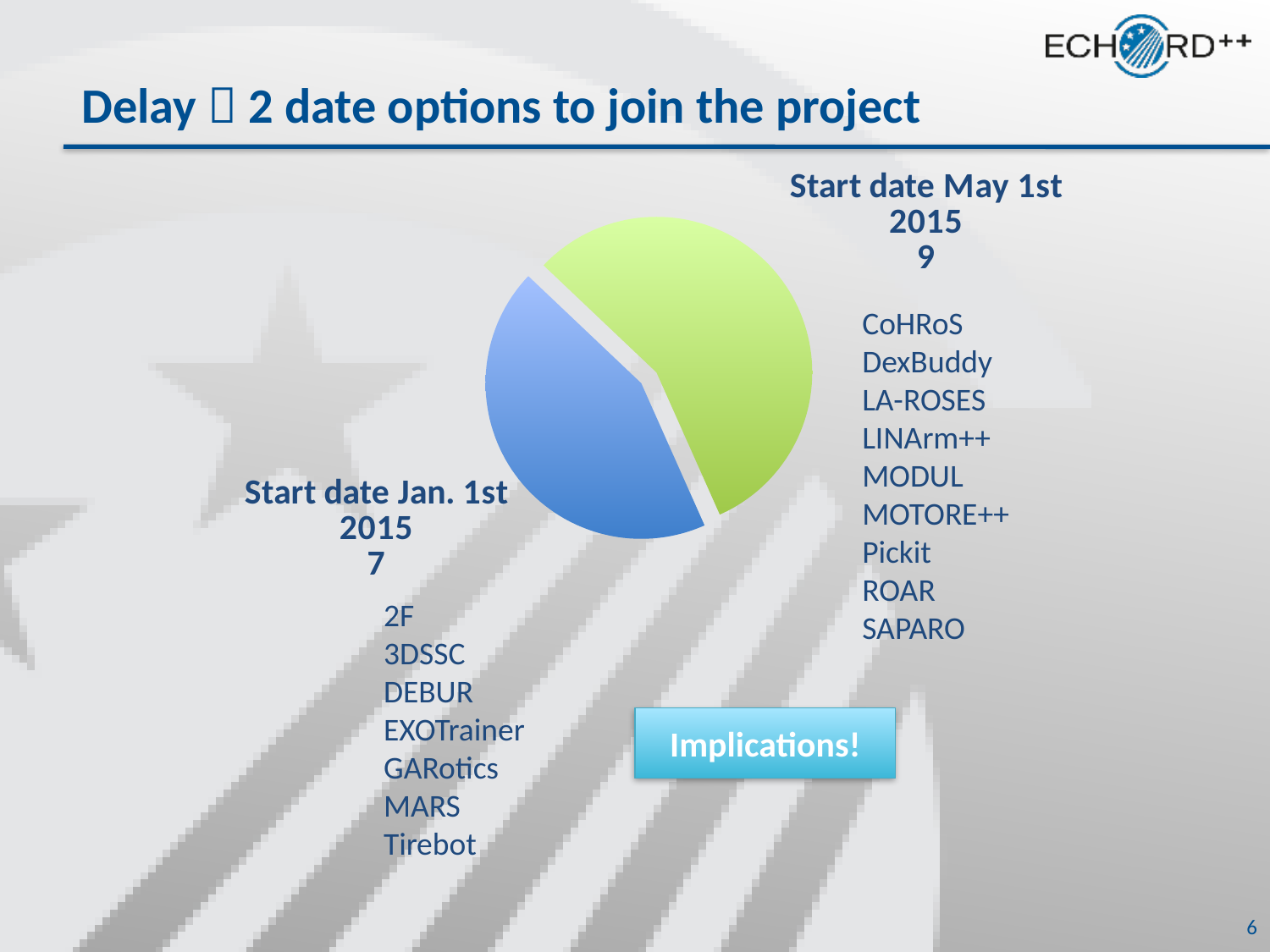
What kind of chart is shown on the slide? pie chart What is the total number of projects represented by the two slices of the pie chart? 16 Is the value for 'Start date Jan. 1st 2015' larger or smaller than the value for 'Start date May 1st 2015'? smaller What colour is the slice for 'Start date May 1st 2015'? green How many slices does the pie chart have? 2 What colour is the slice for 'Start date Jan. 1st 2015'? blue Which start date option has the larger slice of the pie? Start date May 1st 2015 What is the value for the 'Start date Jan. 1st 2015' slice? 7 What is the difference between the number of projects starting May 1st 2015 and the number starting Jan. 1st 2015? 2 Which start date option has the smaller slice of the pie? Start date Jan. 1st 2015 What is the value for the 'Start date May 1st 2015' slice? 9